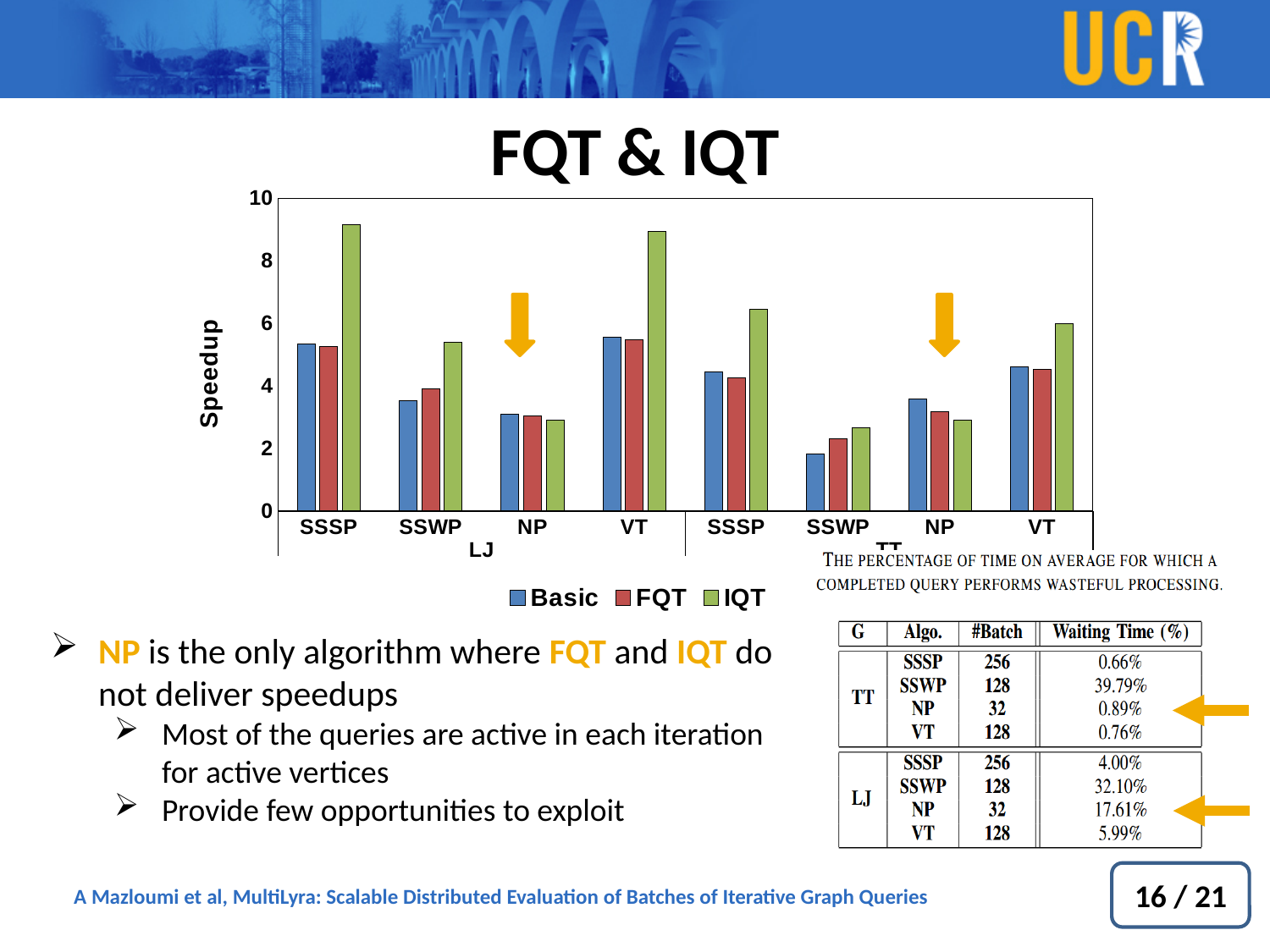
What kind of chart is shown on the slide? bar chart Is the IQT value for SSSP in the LJ group greater or less than 8? greater For NP in the TT group, which is larger: the Basic value or the IQT value? Basic Is the IQT value for SSSP in the TT group greater or less than 6? greater How many series does the chart legend list? 3 Which bar in the chart is the lowest overall? Basic for SSWP in TT Is the IQT value for SSWP in the LJ group greater or less than 4? greater What is the label of the y axis of the chart? Speedup For SSSP in the LJ group, which is larger: the Basic value or the IQT value? IQT Which colour represents the IQT series in the chart? green How many algorithm categories are plotted along the x axis of the chart? 8